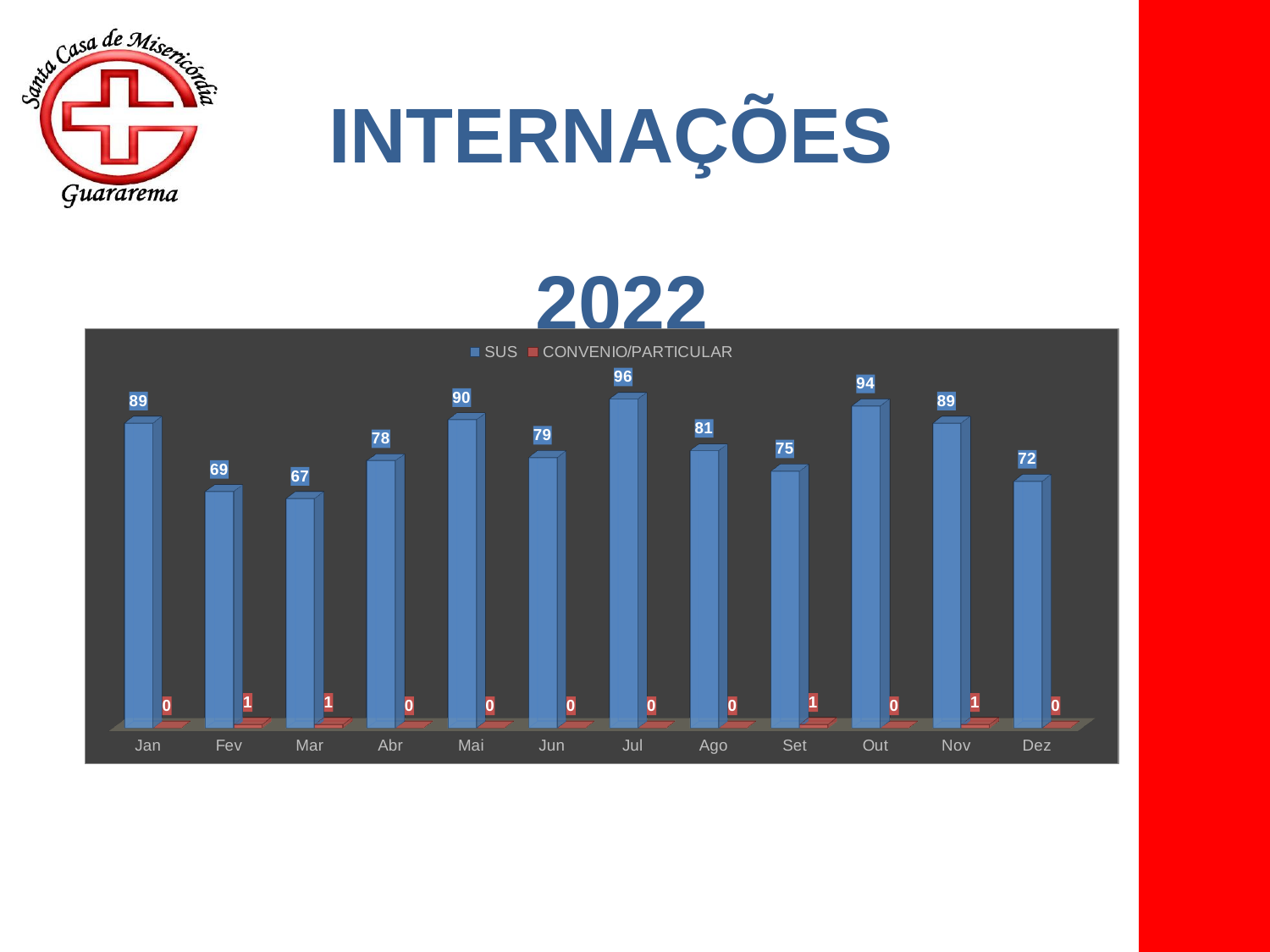
Which month has the highest SUS value? Jul Which month has the lowest SUS value? Mar What is the CONVENIO/PARTICULAR value for Set? 1 What is the SUS value for Mar? 67 How many months are shown on the x axis? 12 What kind of chart is shown on the slide? Bar chart Which is larger, the SUS value for Mai or the SUS value for Ago? Mai How many series does the legend list? 2 What is the difference between the SUS values for Out and Dez? 22 What is the total of the SUS and CONVENIO/PARTICULAR values for Fev? 70 What is the title shown above the chart? 2022 What is the SUS value for Jul? 96